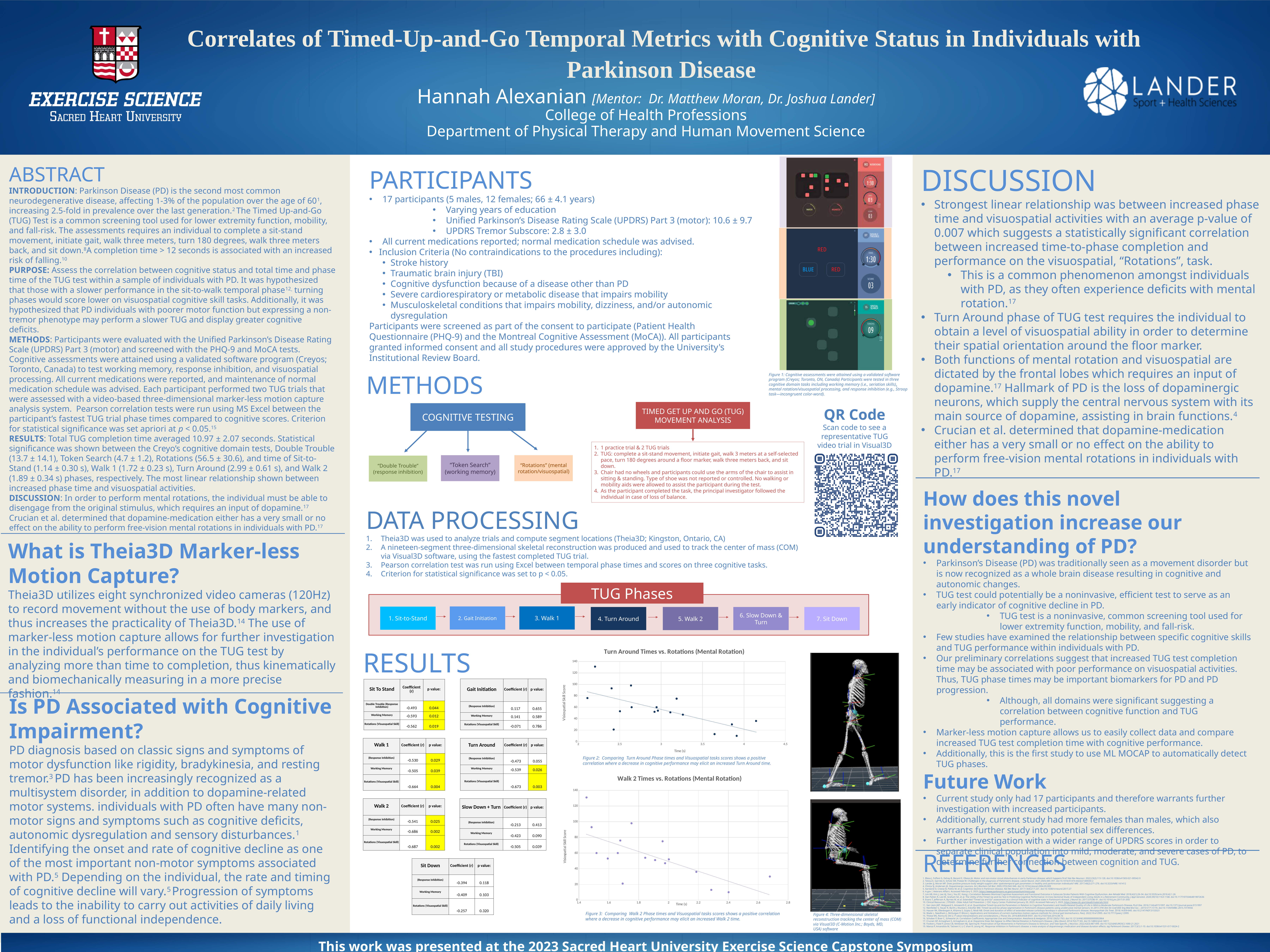
In the 'Turn Around Times vs. Rotations (Mental Rotation)' chart, do the visuospatial skill scores tend to rise or fall as time increases along the x axis? fall What kind of chart is the 'Walk 2 Times vs. Rotations (Mental Rotation)' chart? scatter chart In the 'Walk 2 Times vs. Rotations (Mental Rotation)' chart, does the trend line slope upward or downward as time increases? downward In the 'Walk 2 Times vs. Rotations (Mental Rotation)' chart, is the lowest plotted visuospatial skill score greater or less than 40? less In the 'Turn Around Times vs. Rotations (Mental Rotation)' chart, is the lowest plotted visuospatial skill score greater or less than 40? less In the 'Turn Around Times vs. Rotations (Mental Rotation)' chart, is the highest plotted visuospatial skill score greater or less than 120? greater What is the label of the y axis on the 'Walk 2 Times vs. Rotations (Mental Rotation)' chart? Visuospatial Skill Score What is the label of the x axis on the 'Turn Around Times vs. Rotations (Mental Rotation)' chart? Time (s) What kind of chart is the 'Turn Around Times vs. Rotations (Mental Rotation)' chart? scatter chart